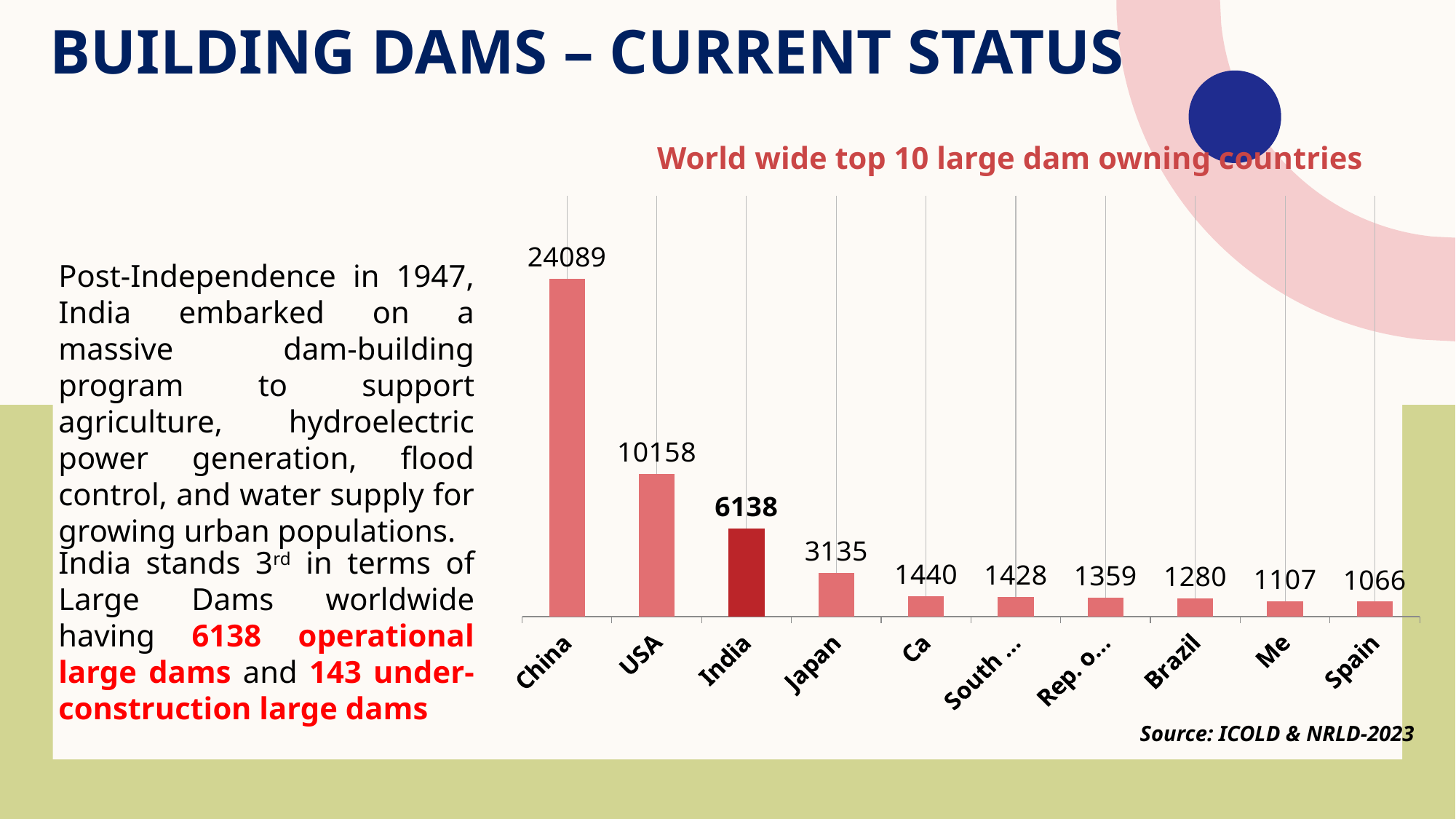
How many countries are shown in the chart? 10 Which is larger, the value for Japan or the value for Brazil? Japan What is the value for India? 6138 What is the value for Brazil? 1280 Which country's bar is shown in a darker colour than the others? India What kind of chart is shown? bar chart What is the value for Japan? 3135 Which country has the lowest value? Spain What is the difference between the values for China and USA? 13931 What is the value for China? 24089 Which country has the highest value? China What is the difference between the values for USA and India? 4020